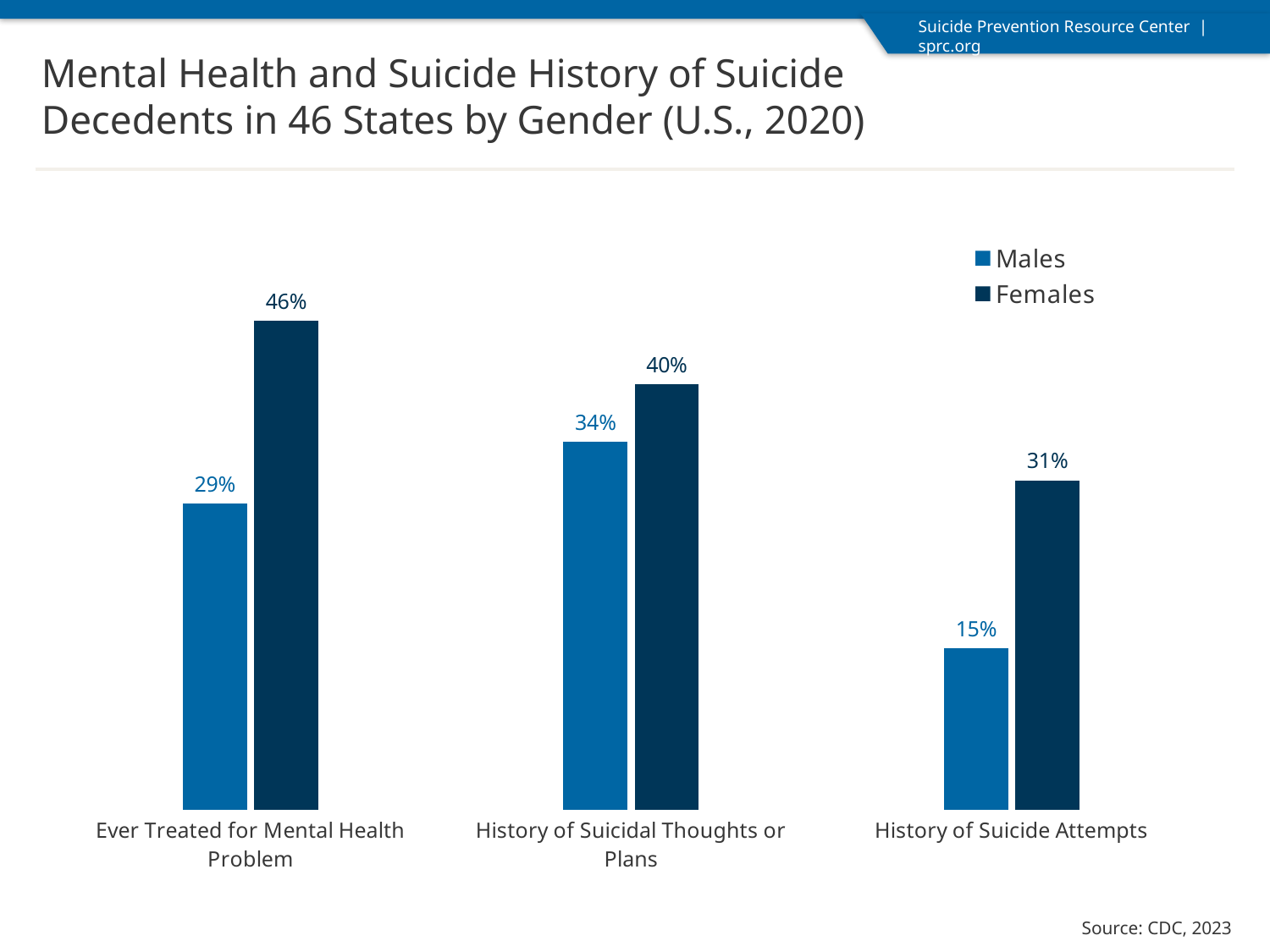
What is the difference between the Females and Males values for Ever Treated for Mental Health Problem? 17% What kind of chart is shown on the slide? Bar chart What percentage of female suicide decedents had a history of suicidal thoughts or plans? 40% What is the value for Females in the Ever Treated for Mental Health Problem category? 46% Which category has the lowest value for Males? History of Suicide Attempts What is the value for Males in the History of Suicide Attempts category? 15% Which category has the highest value for Females? Ever Treated for Mental Health Problem What is the difference between the Females and Males values for History of Suicide Attempts? 16% What percentage of male suicide decedents had ever been treated for a mental health problem? 29% How many categories are shown on the x axis? 3 Which is larger: the Males value for History of Suicidal Thoughts or Plans or the Females value for History of Suicide Attempts? Males value for History of Suicidal Thoughts or Plans How many series does the legend list? 2